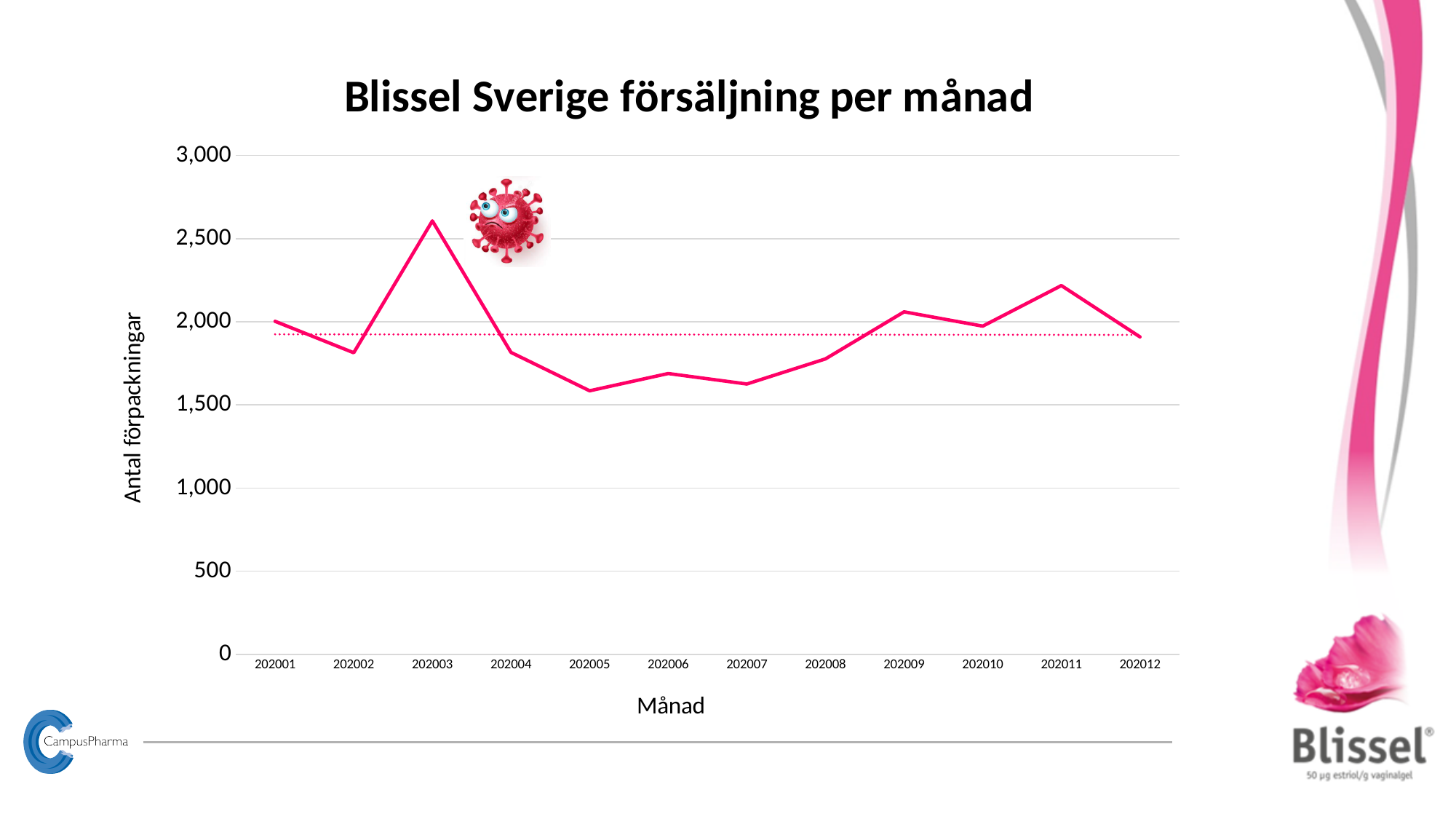
Is the value for 202003 greater or less than 2,500? greater Which month has the highest value? 202003 What is the label on the vertical axis? Antal förpackningar Is the value for 202011 greater or less than 2,000? greater Is the value for 202006 greater or less than 1,500? greater Which is larger, the value for 202005 or the value for 202009? 202009 Do the values rise or fall from 202003 to 202005? fall Which is larger, the value for 202003 or the value for 202011? 202003 How many months are plotted along the x axis? 12 What is the title of the chart? Blissel Sverige försäljning per månad What kind of chart is shown on the slide? line chart